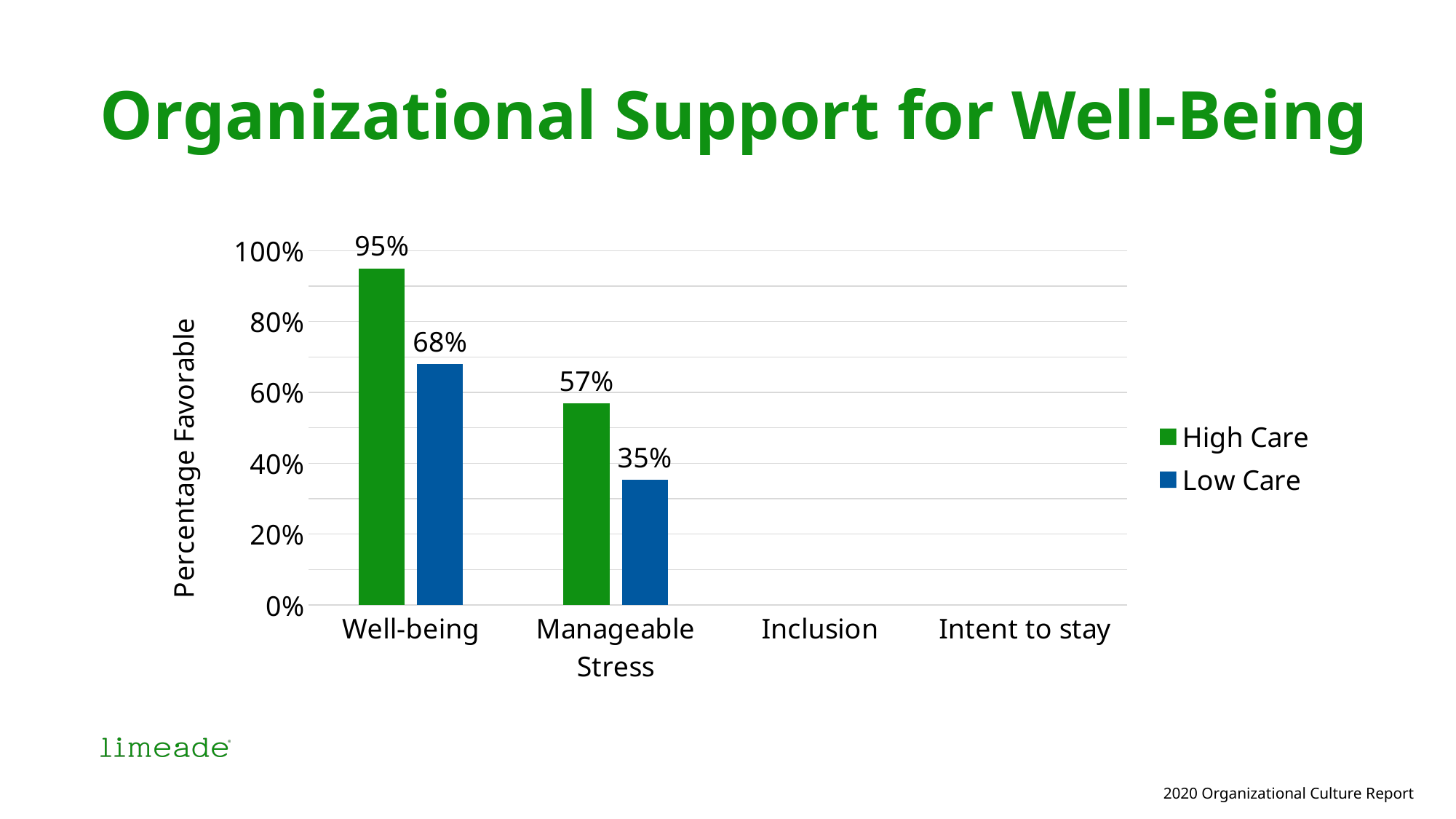
What is the Low Care value for Well-being? 68% How many series does the legend list? 2 Which category has the highest High Care value? Well-being Which is larger for Manageable Stress, the High Care value or the Low Care value? High Care What is the High Care value for Manageable Stress? 57% What kind of chart is shown on the slide? Bar chart What is the difference between the High Care and Low Care values for Well-being? 27% How many category labels are shown on the x axis? 4 What is the label of the vertical axis? Percentage Favorable What is the difference between the High Care and Low Care values for Manageable Stress? 22% What is the Low Care value for Manageable Stress? 35% What is the High Care value for Well-being? 95%